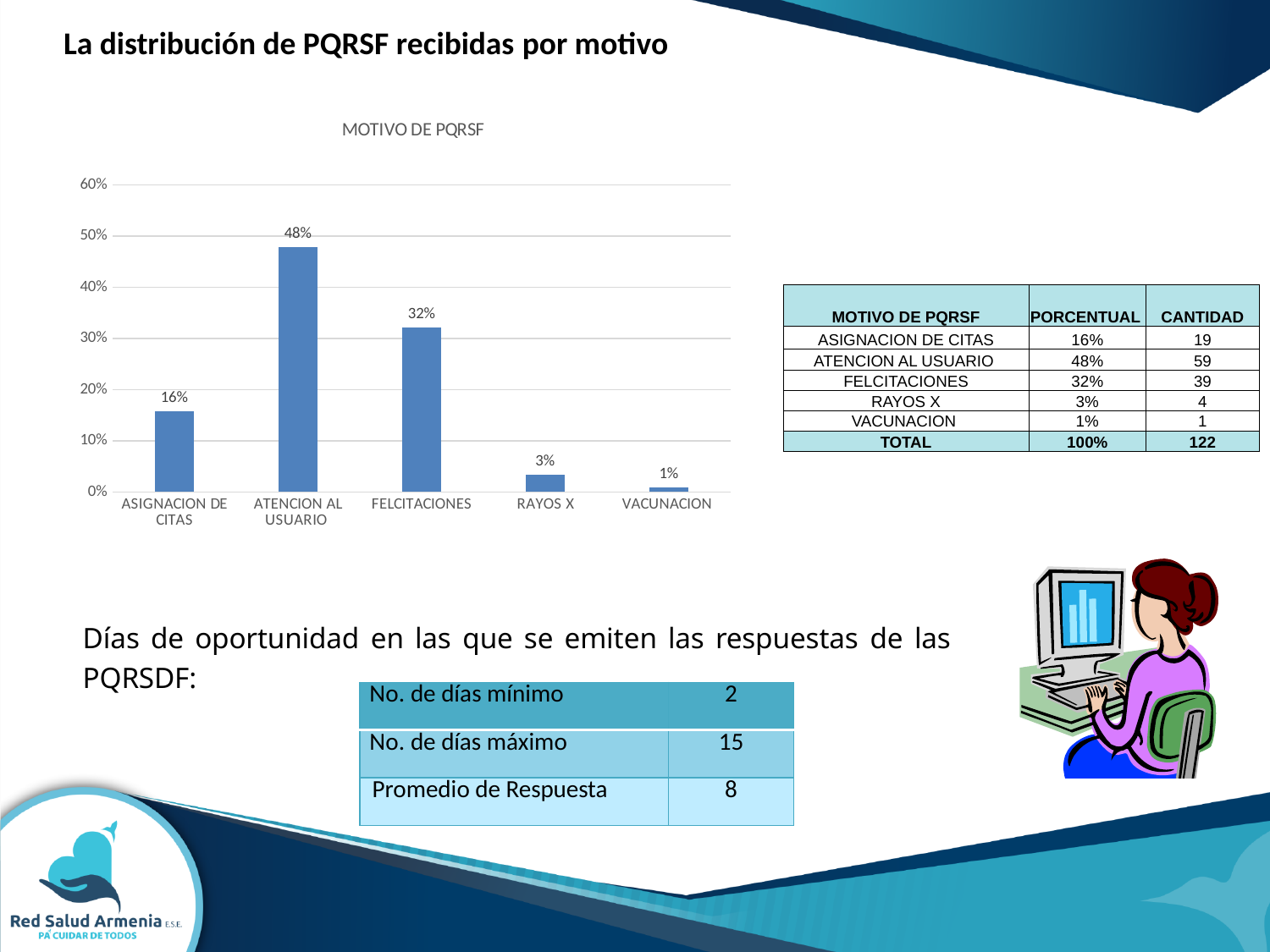
Which category has the lowest value in the MOTIVO DE PQRSF chart? VACUNACION What is the value for RAYOS X in the MOTIVO DE PQRSF chart? 3% Is the value for ASIGNACION DE CITAS in the MOTIVO DE PQRSF chart greater or less than 20%? less How many categories are shown in the MOTIVO DE PQRSF chart? 5 What is the title of the chart on the slide? MOTIVO DE PQRSF What is the highest value shown on the vertical axis of the MOTIVO DE PQRSF chart? 60% What kind of chart is the MOTIVO DE PQRSF chart? bar chart Which is larger in the MOTIVO DE PQRSF chart, ASIGNACION DE CITAS or FELCITACIONES? FELCITACIONES What is the value for FELCITACIONES in the MOTIVO DE PQRSF chart? 32% What is the difference between the values for ATENCION AL USUARIO and FELCITACIONES in the MOTIVO DE PQRSF chart? 16% What is the value for ATENCION AL USUARIO in the MOTIVO DE PQRSF chart? 48% Which category has the highest value in the MOTIVO DE PQRSF chart? ATENCION AL USUARIO